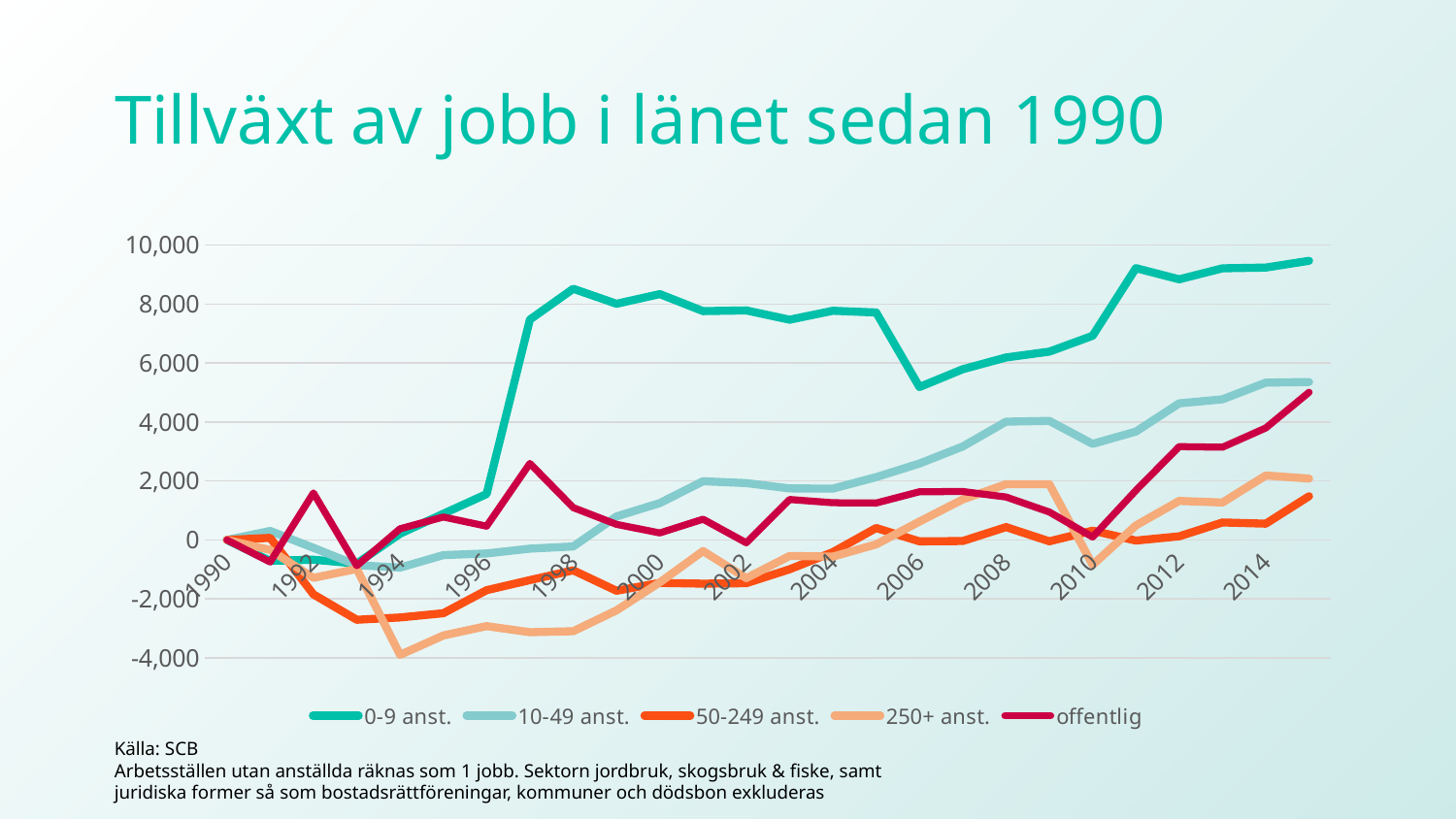
In 2014, which is larger: the value for 0-9 anst. or the value for offentlig? 0-9 anst. How many series does the legend list? 5 Is the value for 0-9 anst. in 2014 greater or less than 8,000? greater What is the title of the chart? Tillväxt av jobb i länet sedan 1990 Is the value for 10-49 anst. in 2014 greater or less than 4,000? greater Does the 10-49 anst. line generally rise or fall from 2000 to 2014? rise What kind of chart is shown on the slide? line chart Which series has the highest value in 2014? 0-9 anst. Is the value for 250+ anst. in 1994 greater or less than -2,000? less Which series is represented by the dark red line in the legend? offentlig Which series has the lowest value in 1994? 250+ anst.